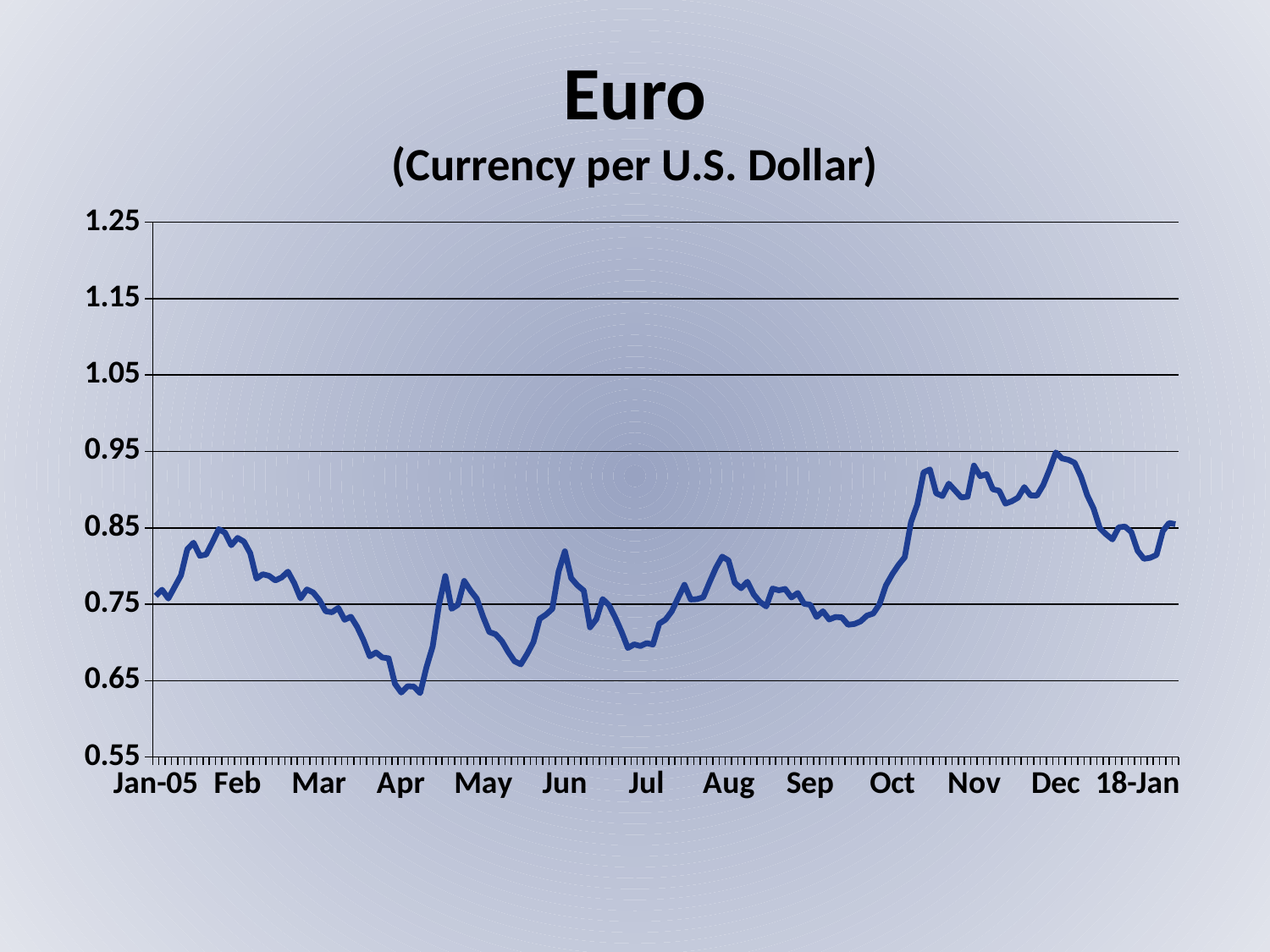
Does the line rise or fall between Oct and Nov? rise What kind of chart is shown on the slide? line chart Does the line rise or fall between Mar and Apr? fall How many month labels are shown on the x axis? 13 What is the highest value shown on the y axis? 1.25 Is the value at Jan-05 greater or less than 0.85? less What is the title of the chart? Euro (Currency per U.S. Dollar) In which month does the line reach its lowest point? Apr Is the value in Nov greater or less than 0.85? greater Is the lowest value in Apr greater or less than 0.75? less In which month does the line reach its highest point? Dec Is the value in Nov higher or lower than the value in Jun? higher